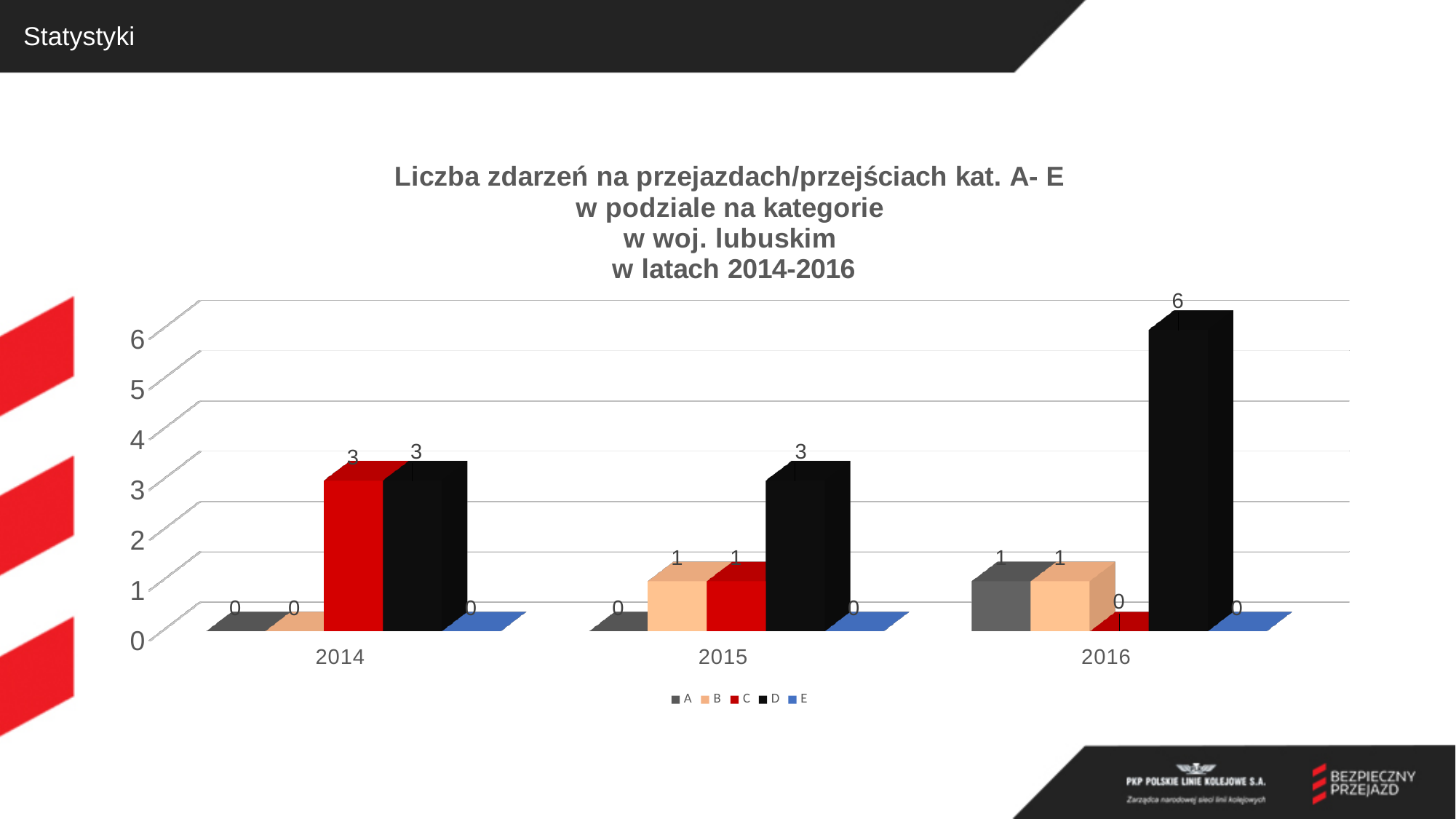
How many years are shown on the x axis? 3 Is the value for series D in 2016 greater or less than 5? greater What kind of chart is shown on the slide? bar chart What is the difference between the value for series D in 2016 and series D in 2015? 3 In which year does series D reach its highest value? 2016 What is the value for series D in 2016? 6 Does the value for series D rise or fall from 2015 to 2016? rise Which is larger: the value for series C in 2014 or series C in 2015? series C in 2014 What is the value for series B in 2015? 1 What is the value for series C in 2014? 3 What is the value for series A in 2016? 1 How many series does the legend list? 5